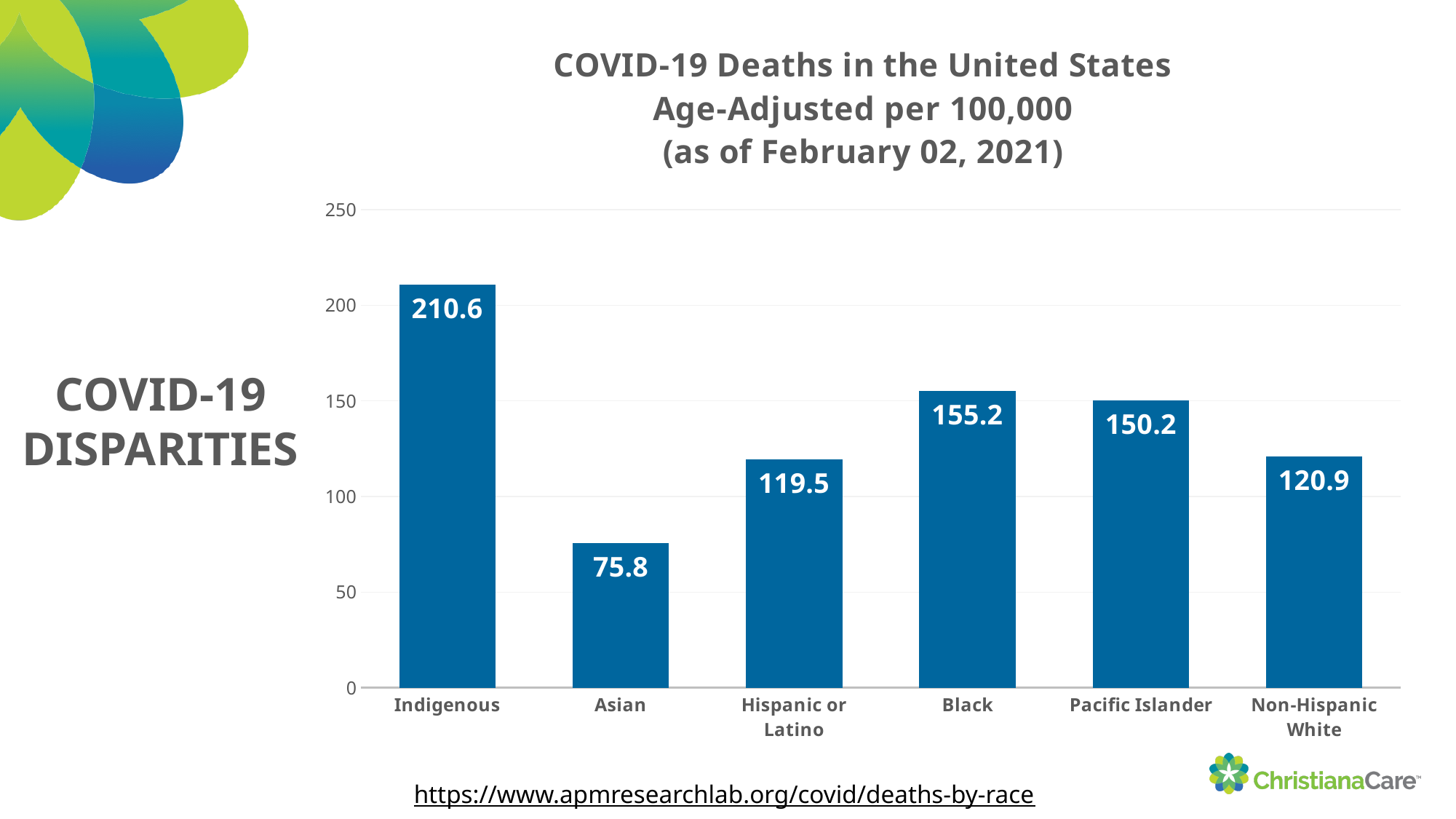
What is the value shown for the Pacific Islander group? 150.2 What is the age-adjusted COVID-19 death rate per 100,000 for the Asian group? 75.8 What is the value shown for the Hispanic or Latino group? 119.5 Which group has the highest age-adjusted COVID-19 death rate? Indigenous Which group has the lowest age-adjusted COVID-19 death rate? Asian How many racial or ethnic groups are shown in the chart? 6 What is the age-adjusted COVID-19 death rate per 100,000 for the Indigenous group? 210.6 What is the difference between the death rates for the Black group and the Non-Hispanic White group? 34.3 Which group has a higher death rate, Black or Pacific Islander? Black Is the value for Non-Hispanic White greater or less than 100? greater What kind of chart is shown on the slide? Bar chart What is the title of the chart? COVID-19 Deaths in the United States Age-Adjusted per 100,000 (as of February 02, 2021)